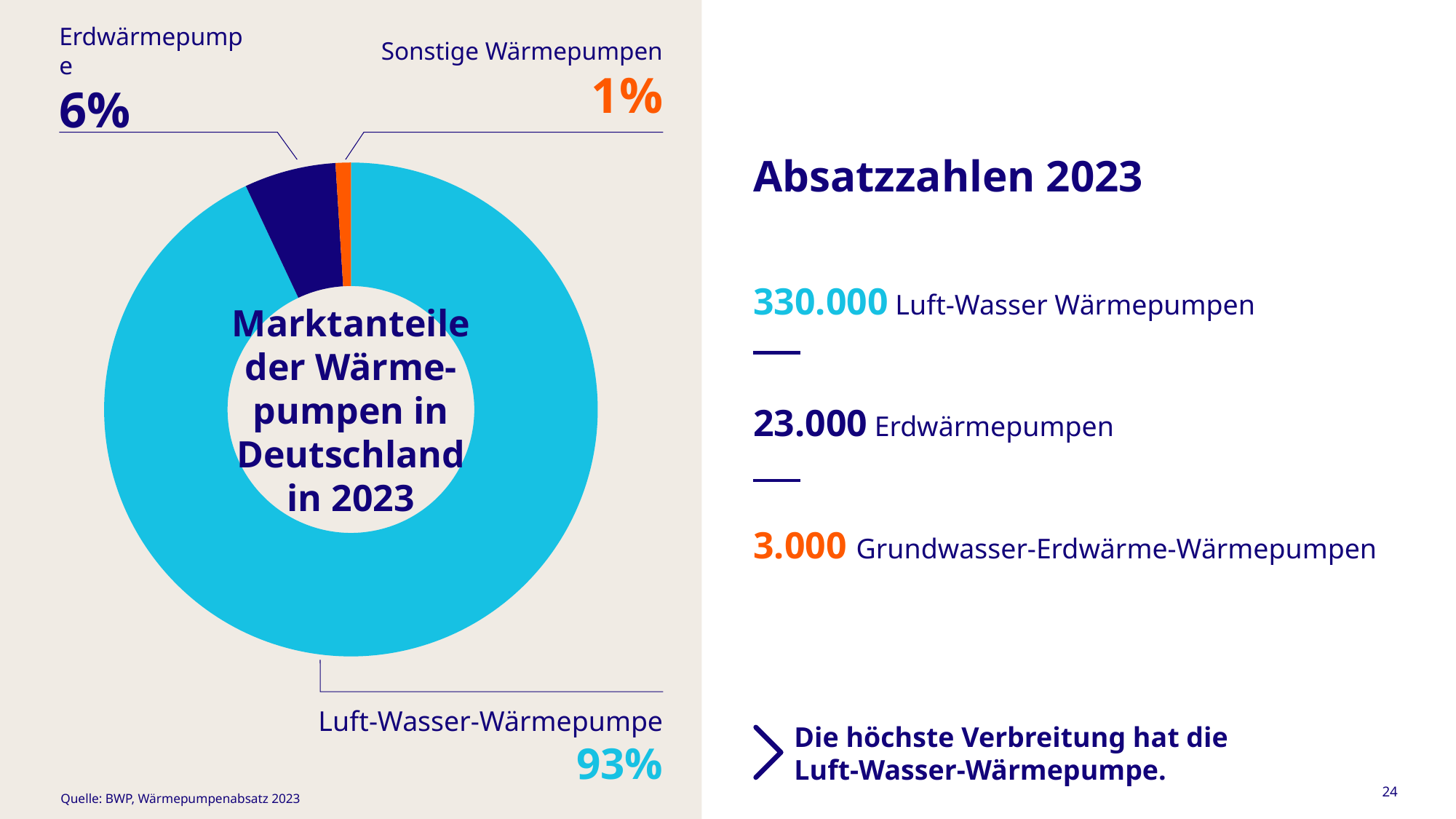
What is the difference in percentage points between the Luft-Wasser-Wärmepumpe share and the Erdwärmepumpe share? 87 percentage points Which category has the smallest share in the donut chart? Sonstige Wärmepumpen What share of the donut chart does Sonstige Wärmepumpen hold? 1% What colour is the Sonstige Wärmepumpen slice in the donut chart? Orange How many categories are shown in the donut chart? 3 Which category has the largest share in the donut chart? Luft-Wasser-Wärmepumpe What share of the donut chart does Luft-Wasser-Wärmepumpe hold? 93% What is the difference in percentage points between the Erdwärmepumpe share and the Sonstige Wärmepumpen share? 5 percentage points What is the title shown in the centre of the donut chart? Marktanteile der Wärmepumpen in Deutschland in 2023 What share of the donut chart does Erdwärmepumpe hold? 6% Which has a larger share in the donut chart, Erdwärmepumpe or Sonstige Wärmepumpen? Erdwärmepumpe What type of chart is shown on the slide? Donut (pie) chart